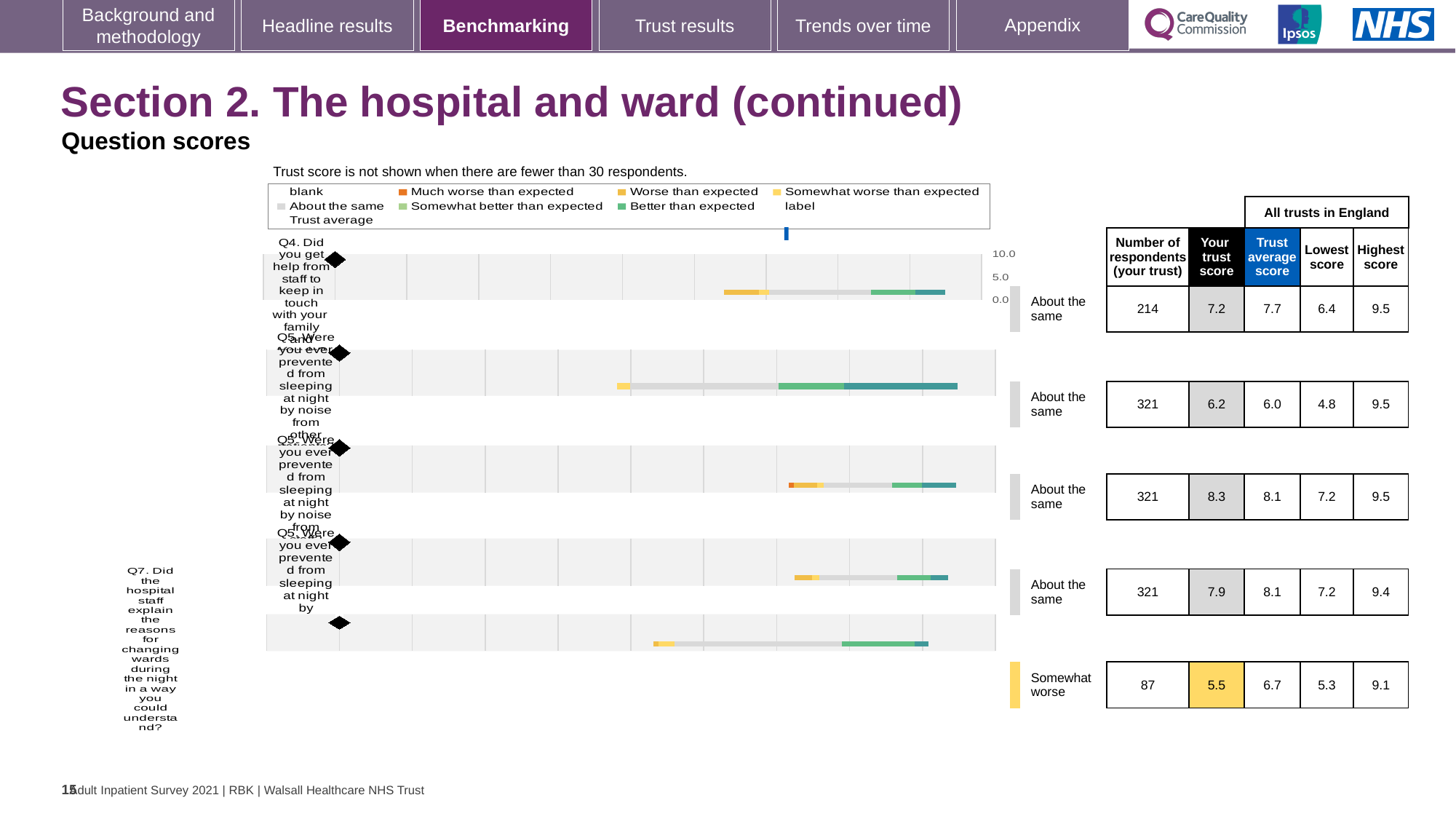
What is the highest value shown on the chart's score axis? 10.0 What is the highest 'Your trust score' shown in the table beside the chart? 8.3 Which question row is labelled 'Somewhat worse' rather than 'About the same'? Q7 (explaining reasons for changing wards during the night) According to the table beside the chart, what is the 'Your trust score' for Q7 (explaining reasons for changing wards during the night)? 5.5 For Q4, which is larger: the 'Your trust score' or the trust average score? Trust average score How many question rows (bars) does the chart show? 5 Which question row has the lowest 'Your trust score' in the table beside the chart? Q7 (explaining reasons for changing wards during the night) According to the table beside the chart, what is the 'Your trust score' for Q4 (help from staff to keep in touch with family and friends)? 7.2 According to the table beside the chart, how many respondents answered Q4 (help from staff to keep in touch with family and friends)? 214 According to the table beside the chart, what is the trust average score for Q7 (explaining reasons for changing wards during the night)? 6.7 For Q7, what is the difference between the trust average score (6.7) and the 'Your trust score' (5.5)? 1.2 What kind of chart is shown on the slide? bar chart